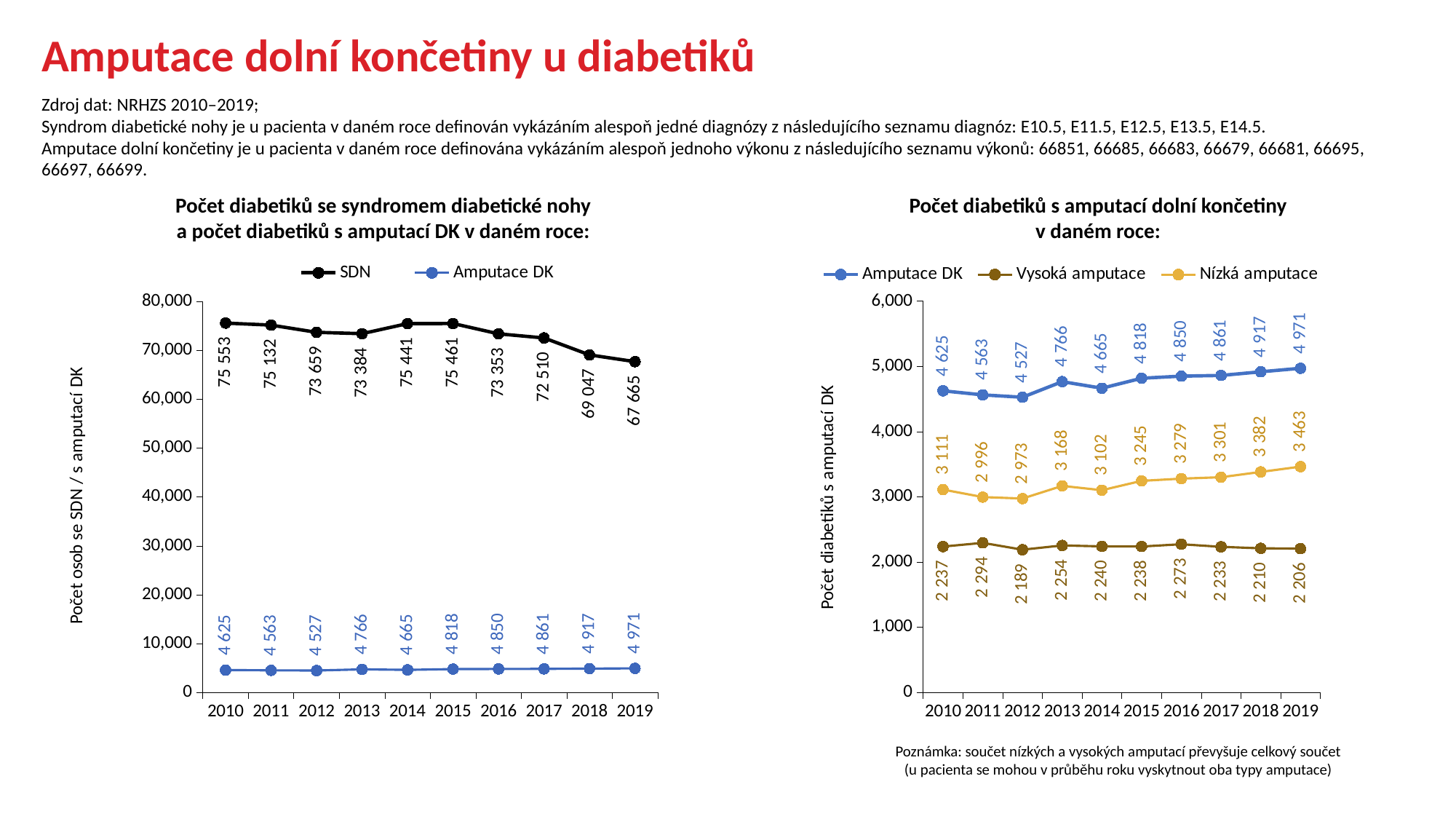
In the right chart (Počet diabetiků s amputací dolní končetiny v daném roce), does the Nízká amputace series rise or fall from 2012 to 2019? Rise In the left chart (Počet diabetiků se syndromem diabetické nohy a počet diabetiků s amputací DK), how many series does the legend list? 2 In the left chart (Počet diabetiků se syndromem diabetické nohy a počet diabetiků s amputací DK), what kind of chart is shown? Line chart In the right chart (Počet diabetiků s amputací dolní končetiny v daném roce), what is the y-axis label? Počet diabetiků s amputací DK In the right chart (Počet diabetiků s amputací dolní končetiny v daném roce), how many years are plotted on the x axis? 10 In the left chart (Počet diabetiků se syndromem diabetické nohy a počet diabetiků s amputací DK), what is the difference between the SDN value in 2010 and in 2019? 7 888 In the right chart (Počet diabetiků s amputací dolní končetiny v daném roce), in which year is the Vysoká amputace value highest? 2011 In the left chart (Počet diabetiků se syndromem diabetické nohy a počet diabetiků s amputací DK), in which year is the SDN value lowest? 2019 In the right chart (Počet diabetiků s amputací dolní končetiny v daném roce), which is larger in 2012: Nízká amputace or Vysoká amputace? Nízká amputace In the right chart (Počet diabetiků s amputací dolní končetiny v daném roce), what is the difference between Amputace DK in 2019 and in 2010? 346 In the right chart (Počet diabetiků s amputací dolní končetiny v daném roce), what is the Nízká amputace value for 2019? 3 463 In the left chart (Počet diabetiků se syndromem diabetické nohy a počet diabetiků s amputací DK), what is the SDN value for 2015? 75 461